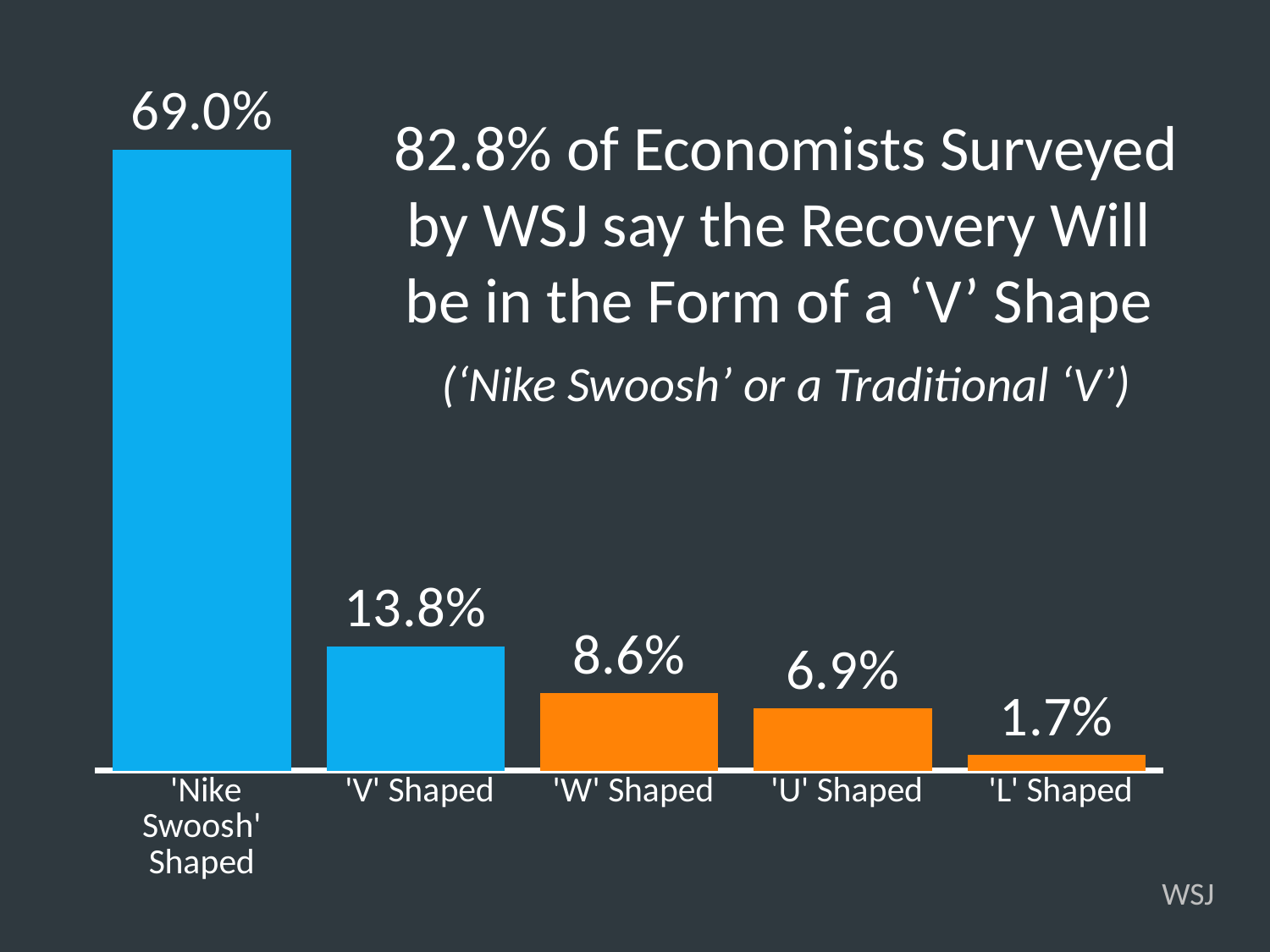
Which is larger, the value for 'U' Shaped or 'L' Shaped? 'U' Shaped What is the combined value of the 'Nike Swoosh' Shaped and 'V' Shaped bars? 82.8% Which recovery shape has the lowest percentage? 'L' Shaped What is the value shown for 'L' Shaped? 1.7% What is the difference between the 'Nike Swoosh' Shaped and 'V' Shaped values? 55.2% What is the difference between the 'W' Shaped and 'U' Shaped values? 1.7% What is the value shown for 'W' Shaped? 8.6% Which recovery shape has the highest percentage? 'Nike Swoosh' Shaped What is the value shown for 'V' Shaped? 13.8% How many recovery shape categories are shown in the chart? 5 What percentage of economists said the recovery will be 'Nike Swoosh' shaped? 69.0% What kind of chart is shown on the slide? Bar chart